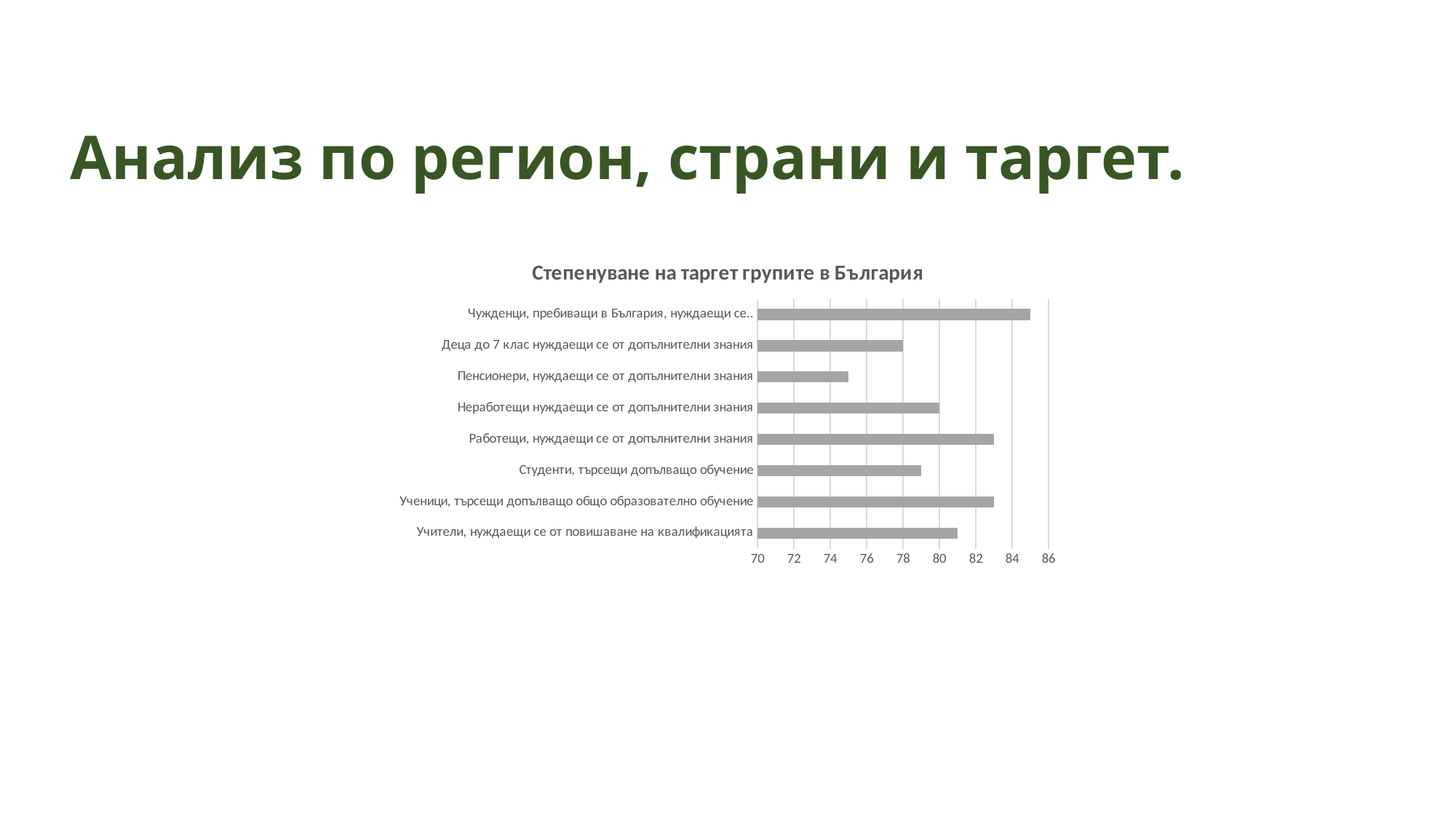
What is the value for "Неработещи нуждаещи се от допълнителни знания"? 80 Is the value for "Пенсионери, нуждаещи се от допълнителни знания" greater or less than 76? less What is the title of the chart? Степенуване на таргет групите в България Which target group has the highest value in the chart? Чужденци, пребиващи в България, нуждаещи се.. What kind of chart is shown on the slide? Bar chart Is the value for "Чужденци, пребиващи в България, нуждаещи се.." greater or less than 84? greater Which has the larger value: "Учители, нуждаещи се от повишаване на квалификацията" or "Чужденци, пребиващи в България, нуждаещи се.."? Чужденци, пребиващи в България, нуждаещи се.. How many target groups (categories) are plotted in the chart? 8 What is the value for "Деца до 7 клас нуждаещи се от допълнителни знания"? 78 Which target group has the lowest value in the chart? Пенсионери, нуждаещи се от допълнителни знания What colour are the bars in the chart? Grey Is the value for "Студенти, търсещи допълващо обучение" greater or less than 80? less